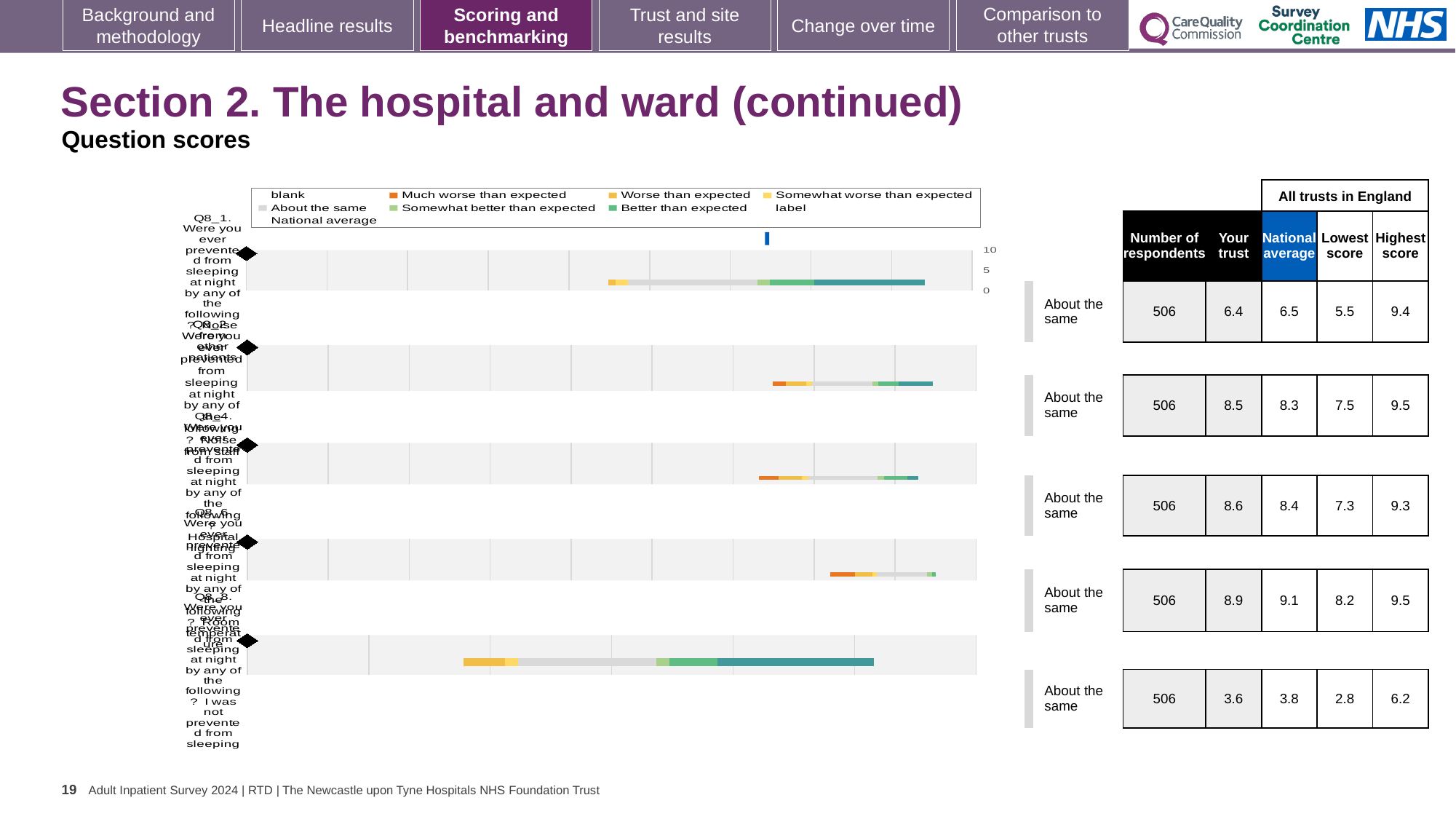
Which legend entry is shown in dark orange in the chart? Much worse than expected In the table beside the chart, what is the national average for the last row (Q8_8)? 3.8 In the table beside the chart, which row has the lowest 'Your trust' score? Q8_8 (3.6) In the table beside the chart, what is the 'Your trust' score for the first row (Q8_1)? 6.4 What kind of chart is used to show the question scores on this slide? bar chart What benchmark label is shown next to each bar in the chart? About the same In the table beside the chart, how many respondents are listed for each question row? 506 In the table beside the chart, which row has the highest 'Your trust' score? Q8_6 (8.9) In the table beside the chart, what is the difference between the 'Your trust' score and the national average for the second row (Q8_2)? 0.2 How many question rows (bars) are plotted in the chart? 5 Which legend entry is shown in grey in the chart? About the same In the table beside the chart, what is the highest score for the fourth row (Q8_6)? 9.5